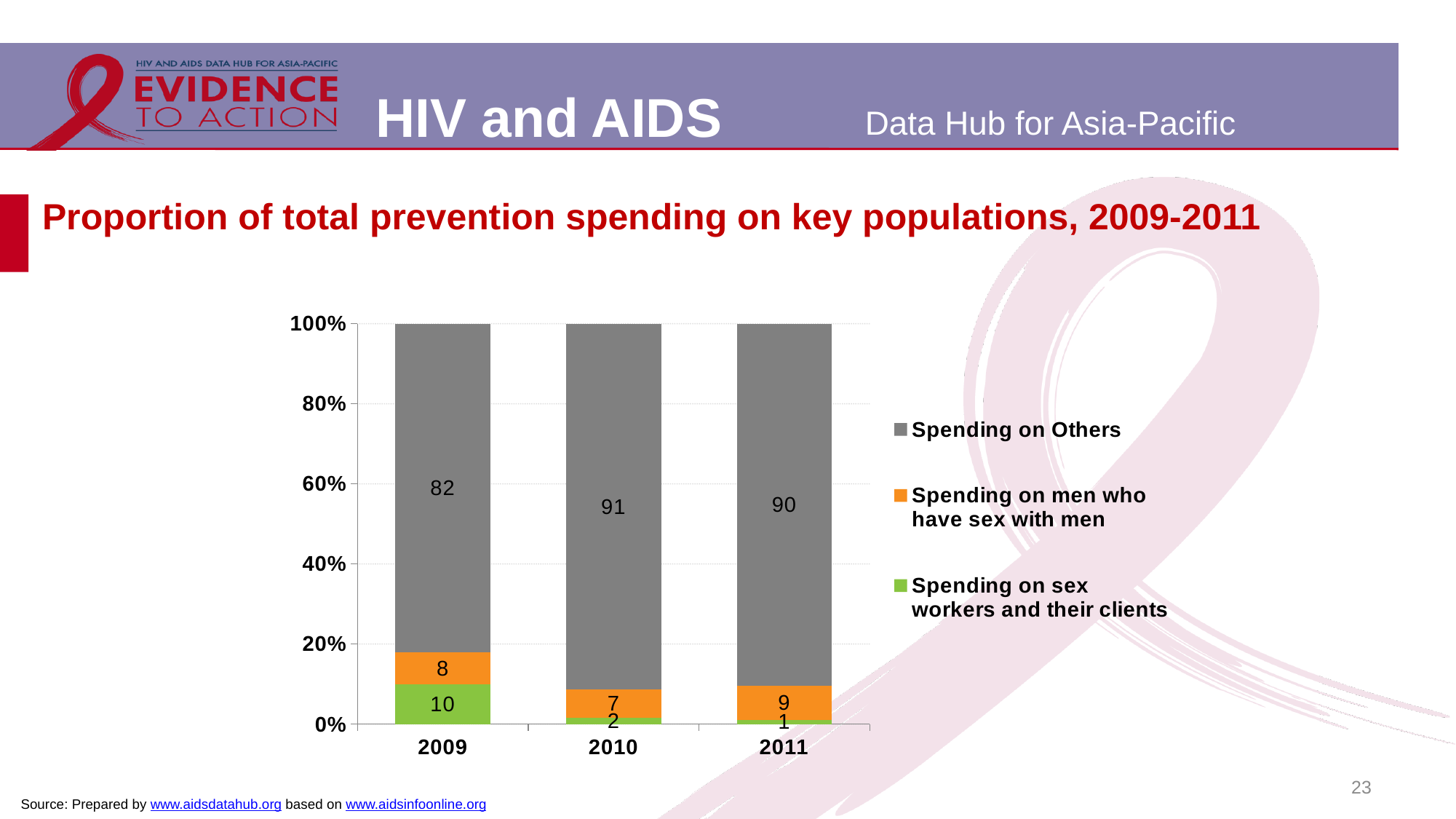
What is the total of the stacked bar for 2011? 100 What is the value for Spending on Others in 2009? 82 What kind of chart is shown on the slide? Stacked bar chart What is the value for Spending on men who have sex with men in 2011? 9 What is the difference between Spending on Others in 2010 and in 2009? 9 In which year is Spending on Others highest? 2010 What is the value for Spending on sex workers and their clients in 2010? 2 Does Spending on sex workers and their clients rise or fall from 2009 to 2011? Fall Which is larger in 2009: Spending on men who have sex with men or Spending on sex workers and their clients? Spending on sex workers and their clients In which year is Spending on sex workers and their clients lowest? 2011 How many series does the legend list? 3 How many years are shown on the x axis? 3